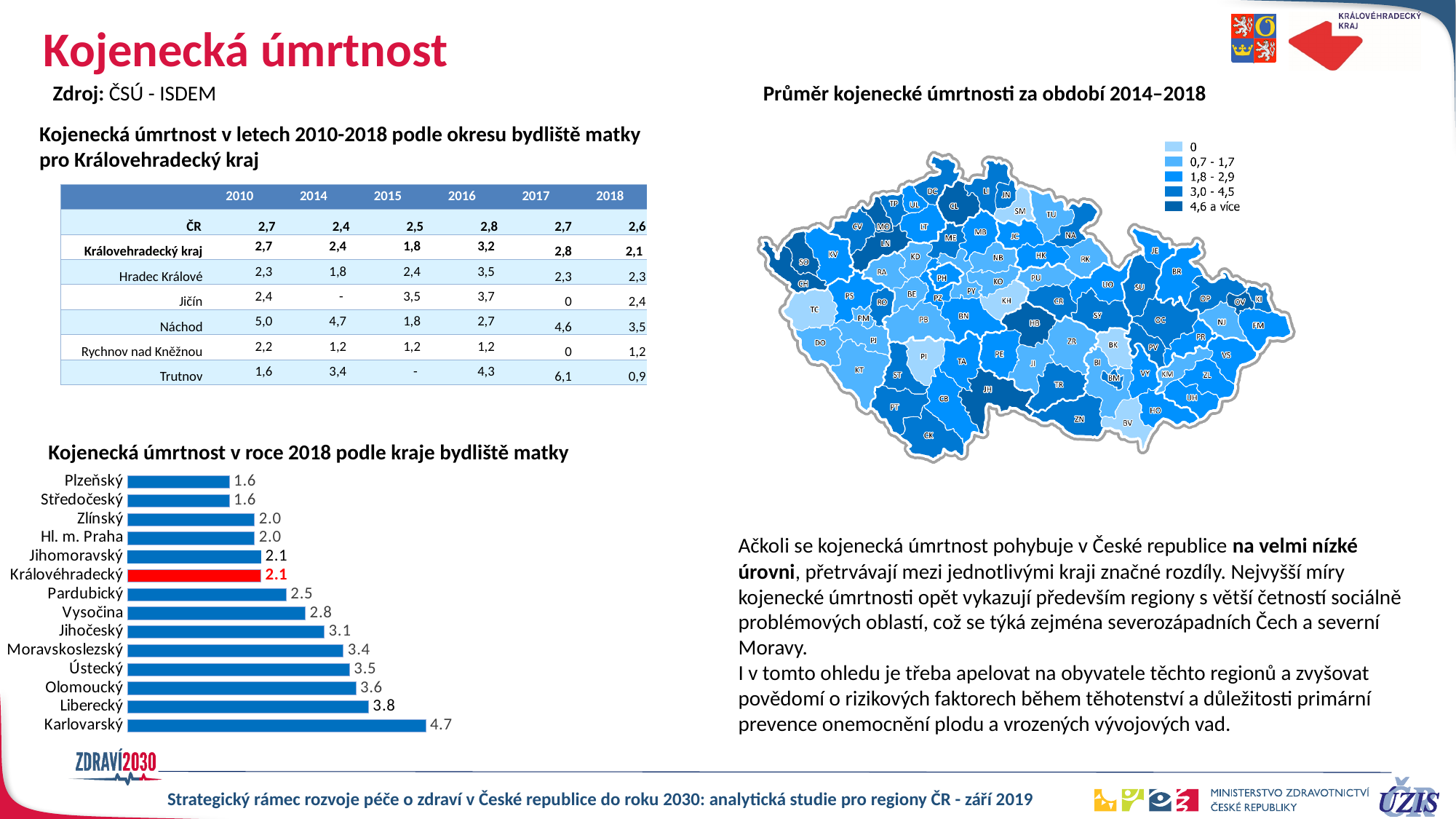
What kind of chart is 'Kojenecká úmrtnost v roce 2018 podle kraje bydliště matky'? Bar chart In the bar chart 'Kojenecká úmrtnost v roce 2018 podle kraje bydliště matky', what is the difference between the values for Olomoucký and Pardubický? 1.1 In the bar chart 'Kojenecká úmrtnost v roce 2018 podle kraje bydliště matky', what is the value for Liberecký? 3.8 In the bar chart 'Kojenecká úmrtnost v roce 2018 podle kraje bydliště matky', what is the value for Karlovarský? 4.7 In the bar chart 'Kojenecká úmrtnost v roce 2018 podle kraje bydliště matky', which region's bar is highlighted in red? Královéhradecký In the bar chart 'Kojenecká úmrtnost v roce 2018 podle kraje bydliště matky', which has a larger value, Liberecký or Jihočeský? Liberecký In the bar chart 'Kojenecká úmrtnost v roce 2018 podle kraje bydliště matky', what is the lowest value shown? 1.6 In the bar chart 'Kojenecká úmrtnost v roce 2018 podle kraje bydliště matky', what is the difference between the values for Karlovarský and Královéhradecký? 2.6 In the bar chart 'Kojenecká úmrtnost v roce 2018 podle kraje bydliště matky', what is the value for Vysočina? 2.8 How many regions are shown in the bar chart 'Kojenecká úmrtnost v roce 2018 podle kraje bydliště matky'? 14 In the bar chart 'Kojenecká úmrtnost v roce 2018 podle kraje bydliště matky', which region has the highest value? Karlovarský In the bar chart 'Kojenecká úmrtnost v roce 2018 podle kraje bydliště matky', what is the value for Královéhradecký? 2.1